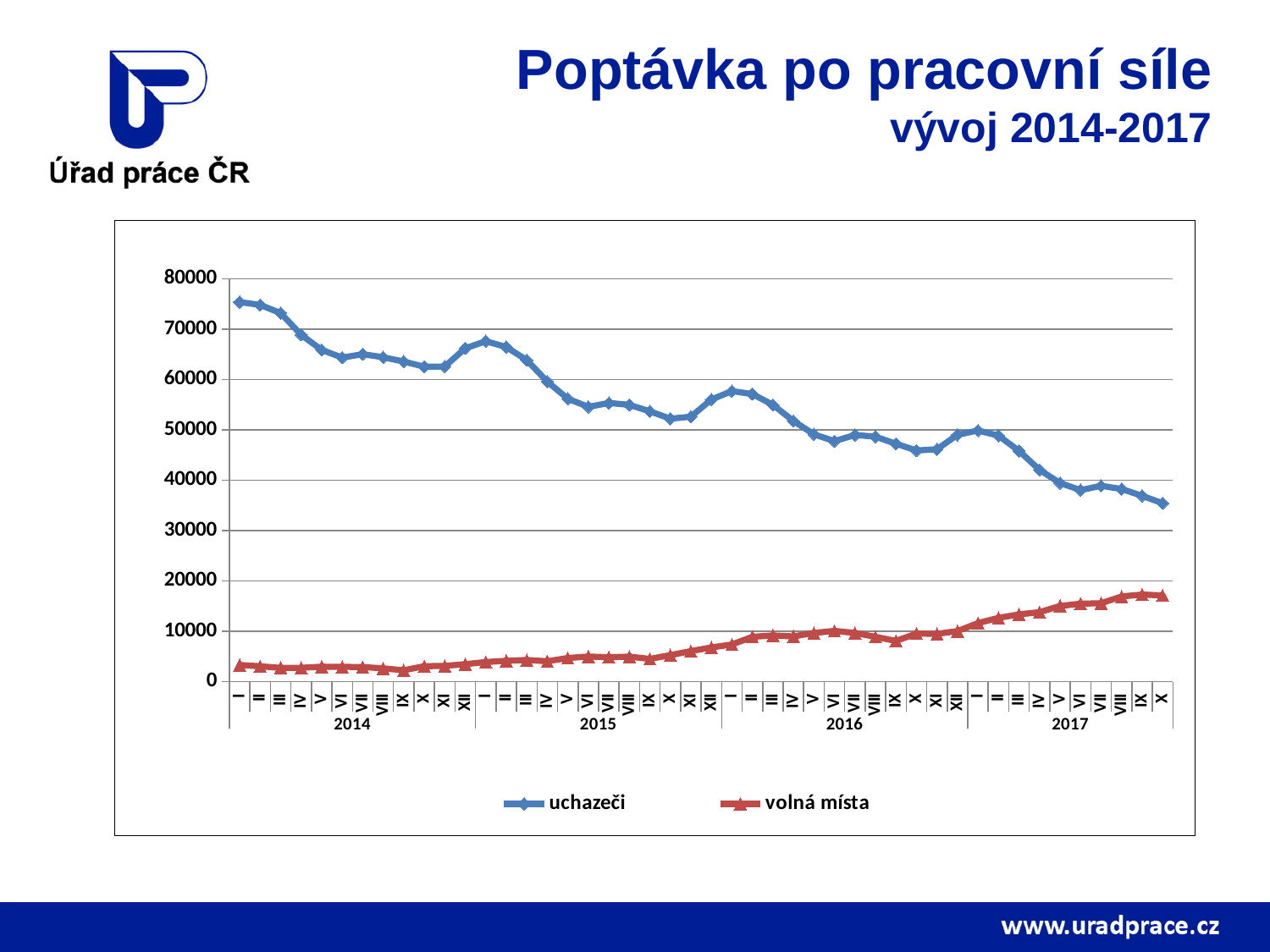
How many years are labelled along the x axis? 4 Does the uchazeči series rise or fall overall from 2014 to 2017? fall At which point on the x axis is the uchazeči series highest? I 2014 Does the volná místa series rise or fall overall from 2014 to 2017? rise Is the value of volná místa in X 2017 greater or less than 10000? greater Is the value of uchazeči in I 2014 greater or less than 70000? greater Is the value of volná místa in I 2014 greater or less than 10000? less What kind of chart is shown on the slide? line chart What are the two series named in the legend? uchazeči and volná místa In X 2017, which series has the larger value, uchazeči or volná místa? uchazeči How many series does the legend list? 2